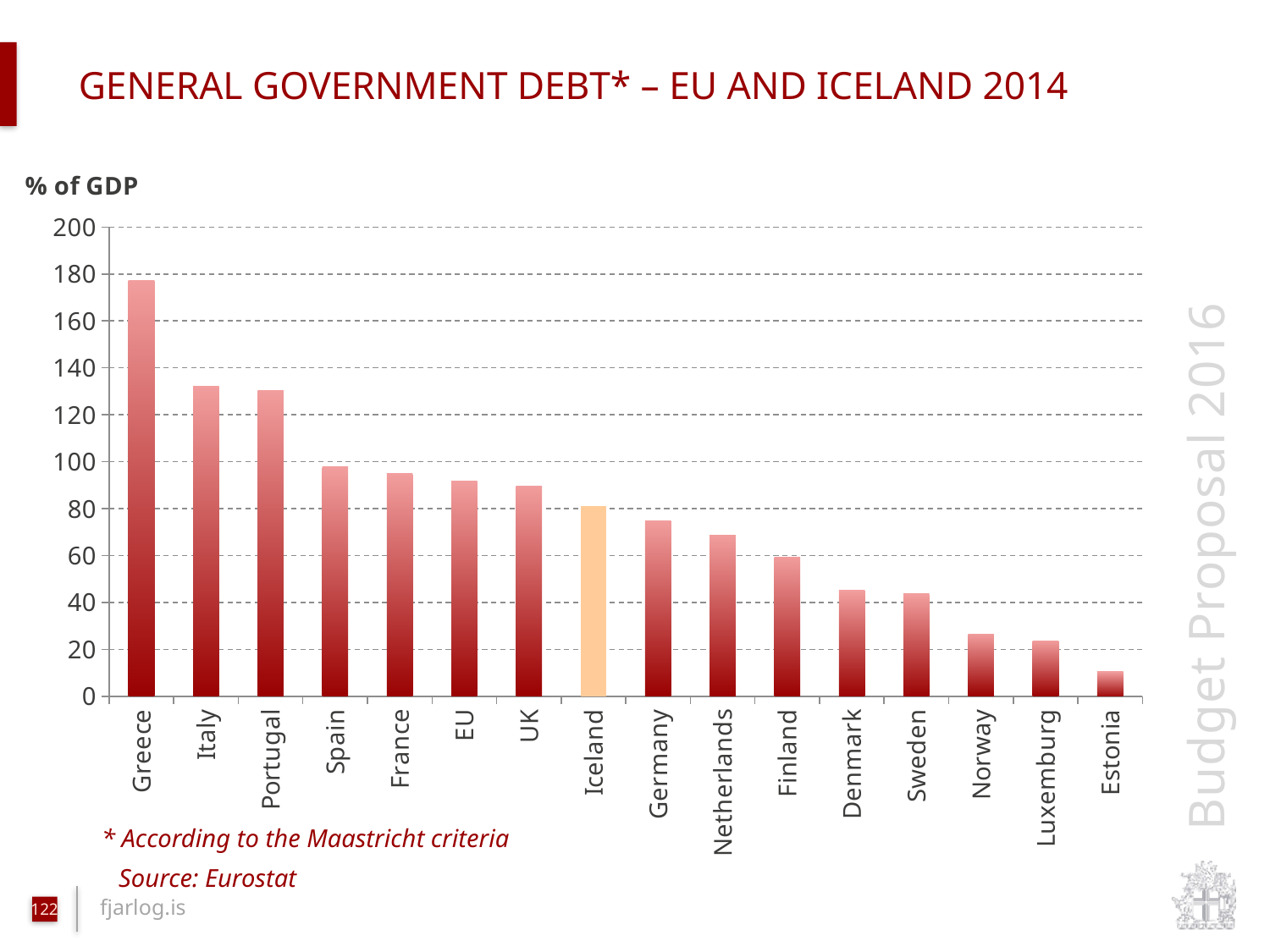
How many countries or regions are shown on the x axis of the chart? 16 Is the value for Germany greater or less than 60? greater What kind of chart is shown on the slide? bar chart Which country has the highest general government debt as % of GDP in the chart? Greece Do the values rise or fall moving from left to right along the x axis? fall Which country has the lowest general government debt as % of GDP in the chart? Estonia Which bar in the chart is coloured differently (orange) from the others? Iceland Which has the larger value, Iceland or Germany? Iceland Is the value for Greece greater or less than 160? greater Is the value for Norway greater or less than 20? greater